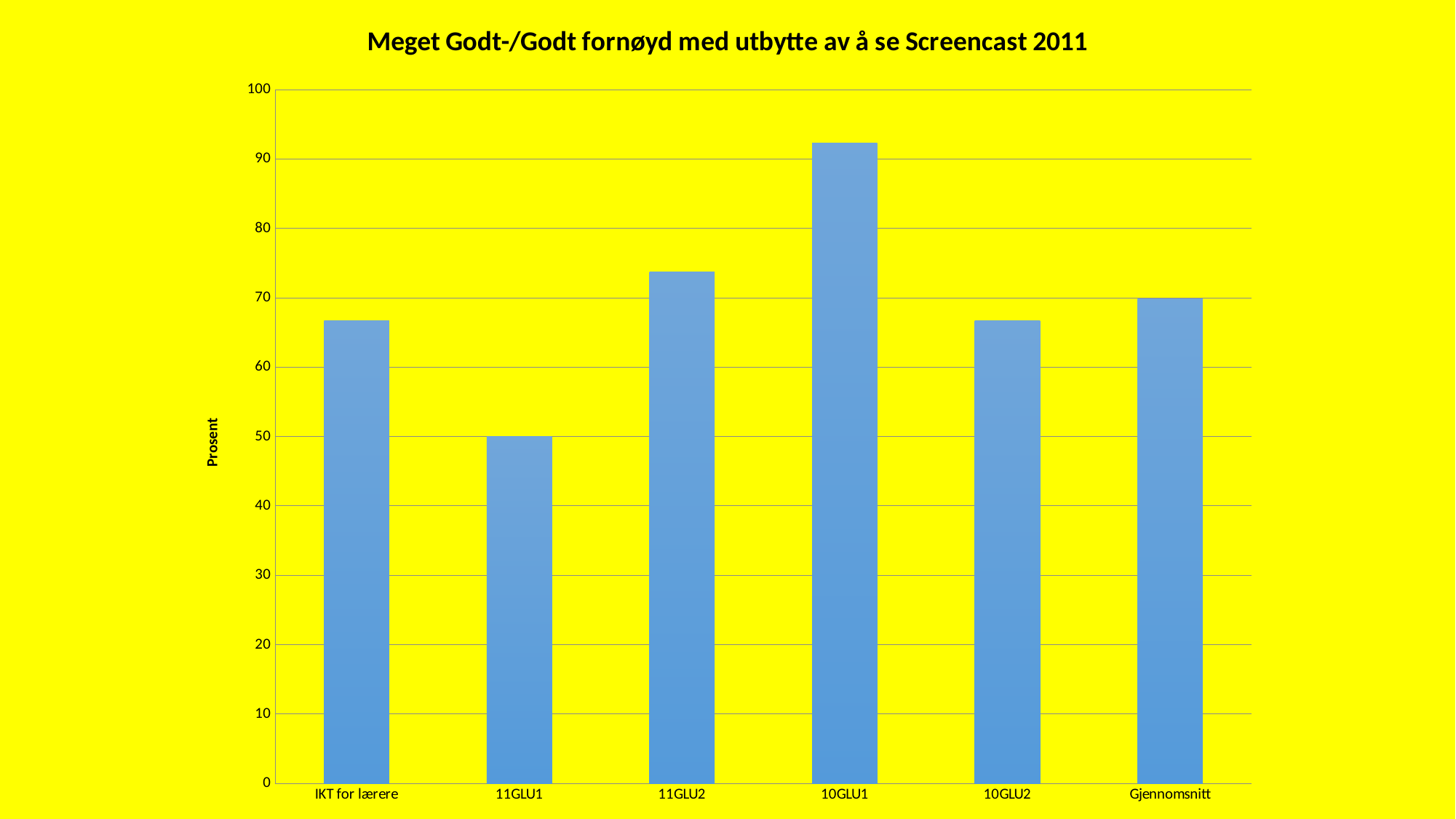
Which category has the lowest value in the chart? 11GLU1 How many categories are shown on the x axis of the chart? 6 Is the value for 10GLU1 greater or less than 90? greater Which category has the highest value in the chart? 10GLU1 What is the title of the chart? Meget Godt-/Godt fornøyd med utbytte av å se Screencast 2011 What is the value for 11GLU1? 50 Is the value for 10GLU2 greater or less than 70? less Is the value for IKT for lærere greater or less than 60? greater What is the label of the vertical axis? Prosent What type of chart is shown on the slide? bar chart Which is larger, the value for 10GLU1 or the value for 11GLU2? 10GLU1